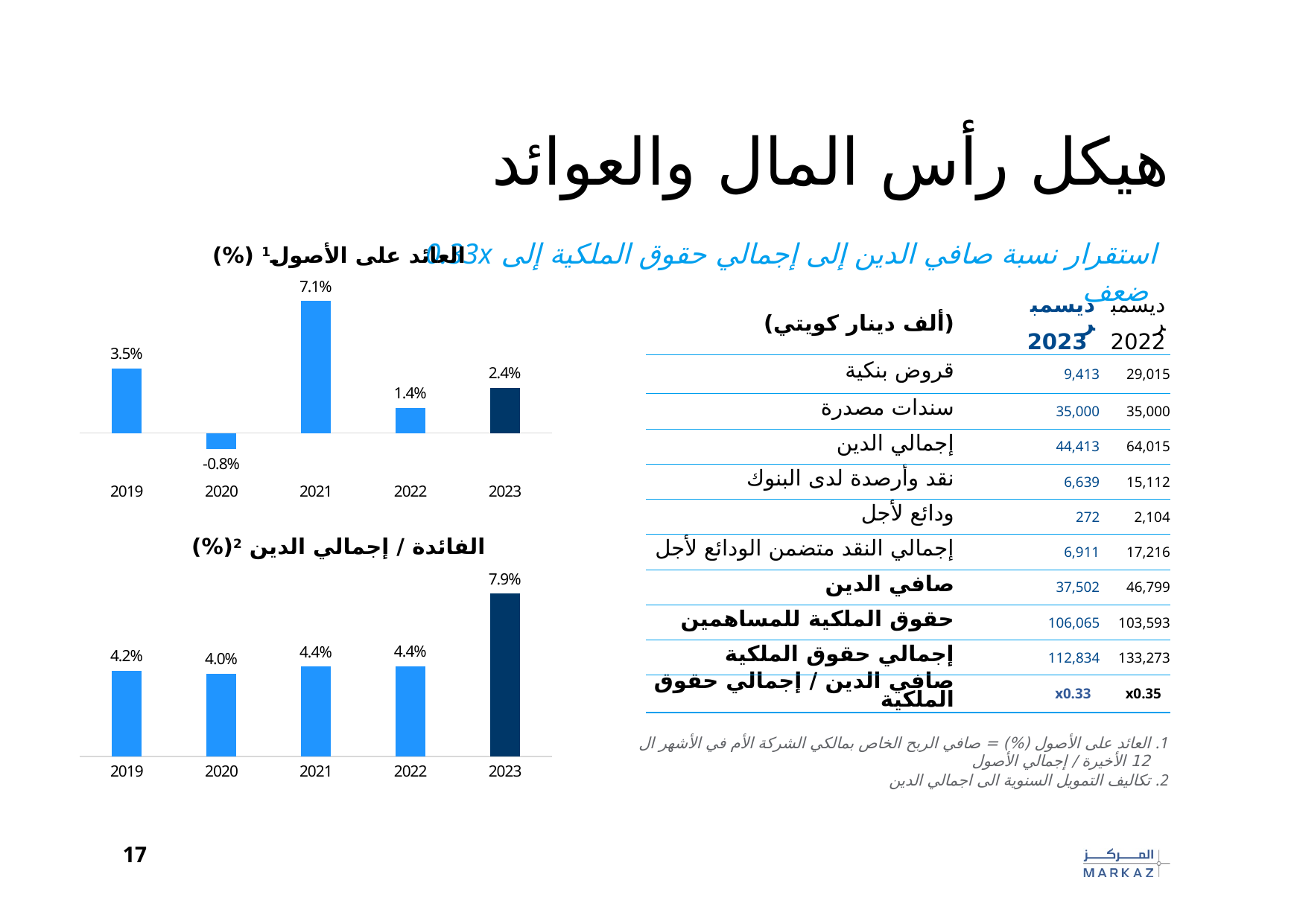
In the top chart (العائد على الأصول), what is the value for 2021? 7.1% In the top chart (العائد على الأصول), which year has the highest value? 2021 In the bottom chart (الفائدة / إجمالي الدين), which year has the highest value? 2023 In the bottom chart (الفائدة / إجمالي الدين), what is the value for 2023? 7.9% In the bottom chart (الفائدة / إجمالي الدين), what is the value for 2020? 4.0% In the top chart (العائد على الأصول), which year has the lowest value? 2020 In the top chart (العائد على الأصول), how many years are shown? 5 In the top chart (العائد على الأصول), what is the difference between the 2019 value and the 2023 value? 1.1% In the top chart (العائد على الأصول), what is the value for 2020? -0.8% In the bottom chart (الفائدة / إجمالي الدين), what is the difference between the 2023 value and the 2022 value? 3.5% In the bottom chart (الفائدة / إجمالي الدين), which is larger, the value for 2019 or the value for 2023? 2023 What type of chart is the bottom chart (الفائدة / إجمالي الدين)? Bar chart